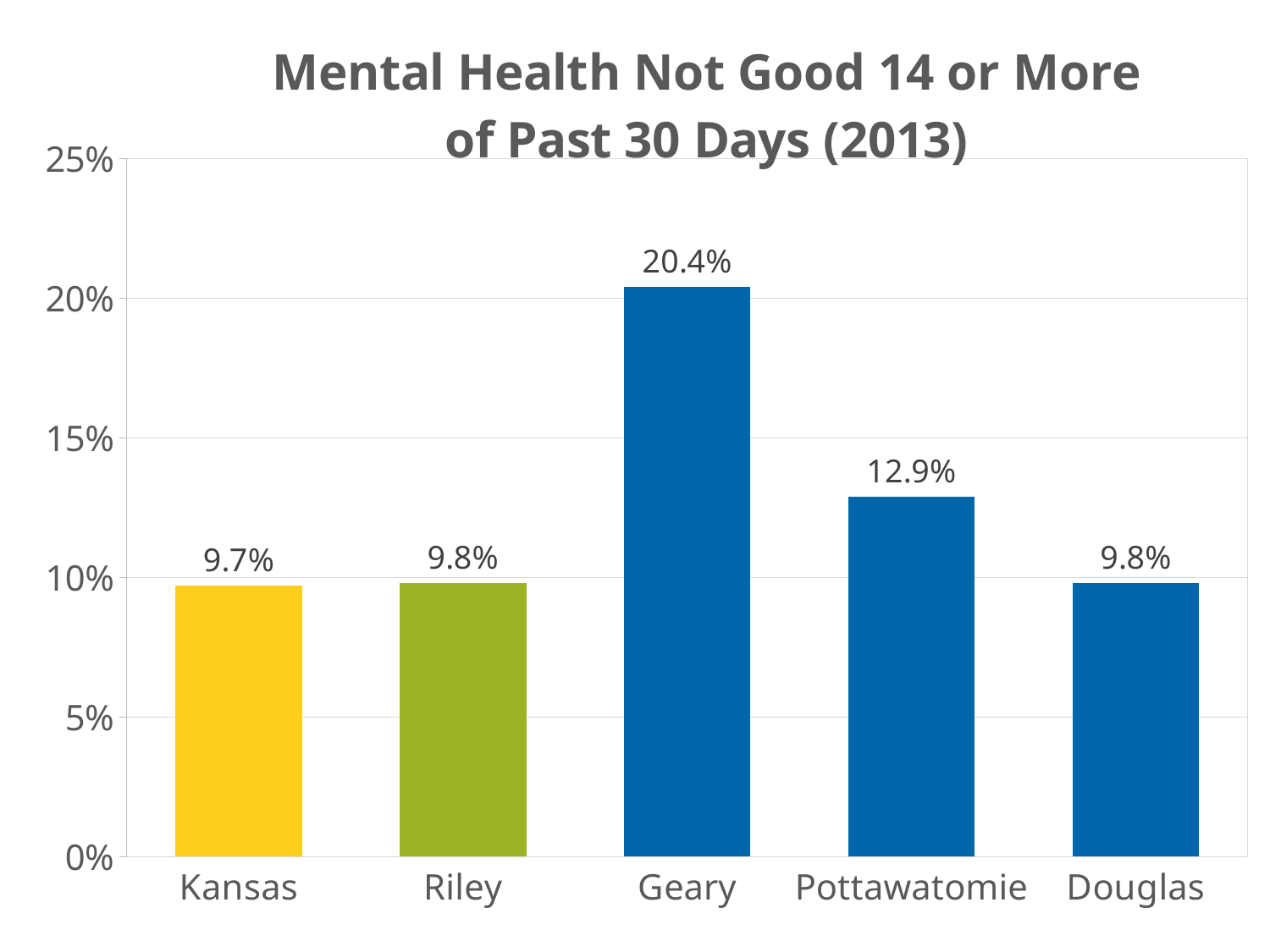
What is the value for Pottawatomie? 12.9% Is the value for Geary greater or less than 20%? greater How many categories are shown on the x axis? 5 What is the value for Kansas? 9.7% What is the difference between the values for Geary and Pottawatomie? 7.5% Which is larger, the value for Geary or the value for Pottawatomie? Geary What is the title of the chart? Mental Health Not Good 14 or More of Past 30 Days (2013) What is the difference between the values for Pottawatomie and Douglas? 3.1% Which category has the lowest value? Kansas Which category has the highest value? Geary What kind of chart is shown on the slide? bar chart What is the value for Geary? 20.4%